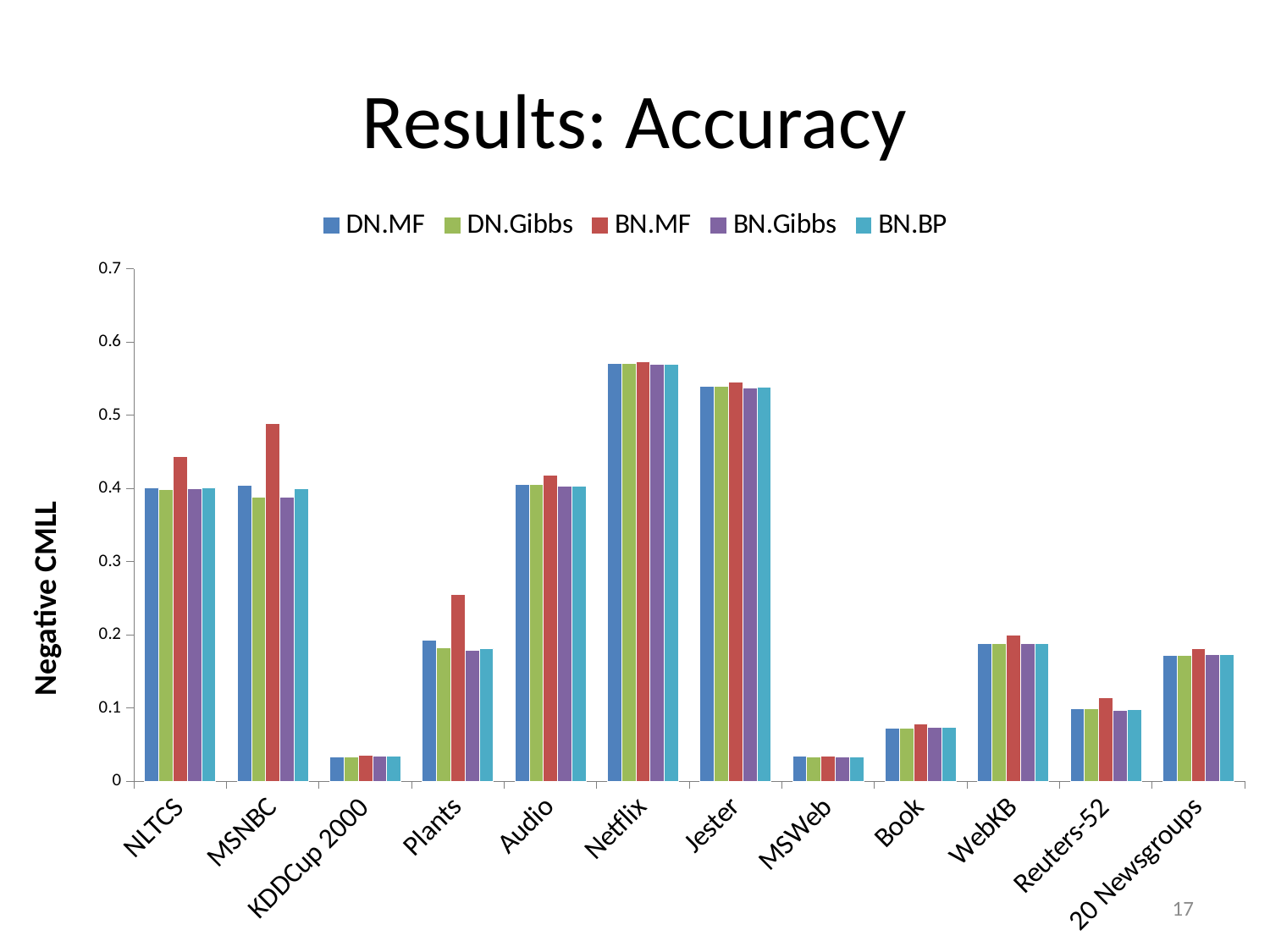
Is the DN.MF value for Netflix greater or less than 0.5? greater Is the DN.Gibbs value for Book greater or less than 0.1? less Which is larger, the BN.MF value for MSNBC or the BN.MF value for NLTCS? MSNBC How many series does the legend list? 5 Is the BN.MF value for Plants greater or less than 0.2? greater How many datasets (categories) are shown along the x axis? 12 Which dataset has the highest Negative CMLL values overall? Netflix For the Plants dataset, which series has the highest bar? BN.MF For the MSNBC dataset, which series has the highest bar? BN.MF What kind of chart is shown on the slide? bar chart What is the label on the y axis? Negative CMLL